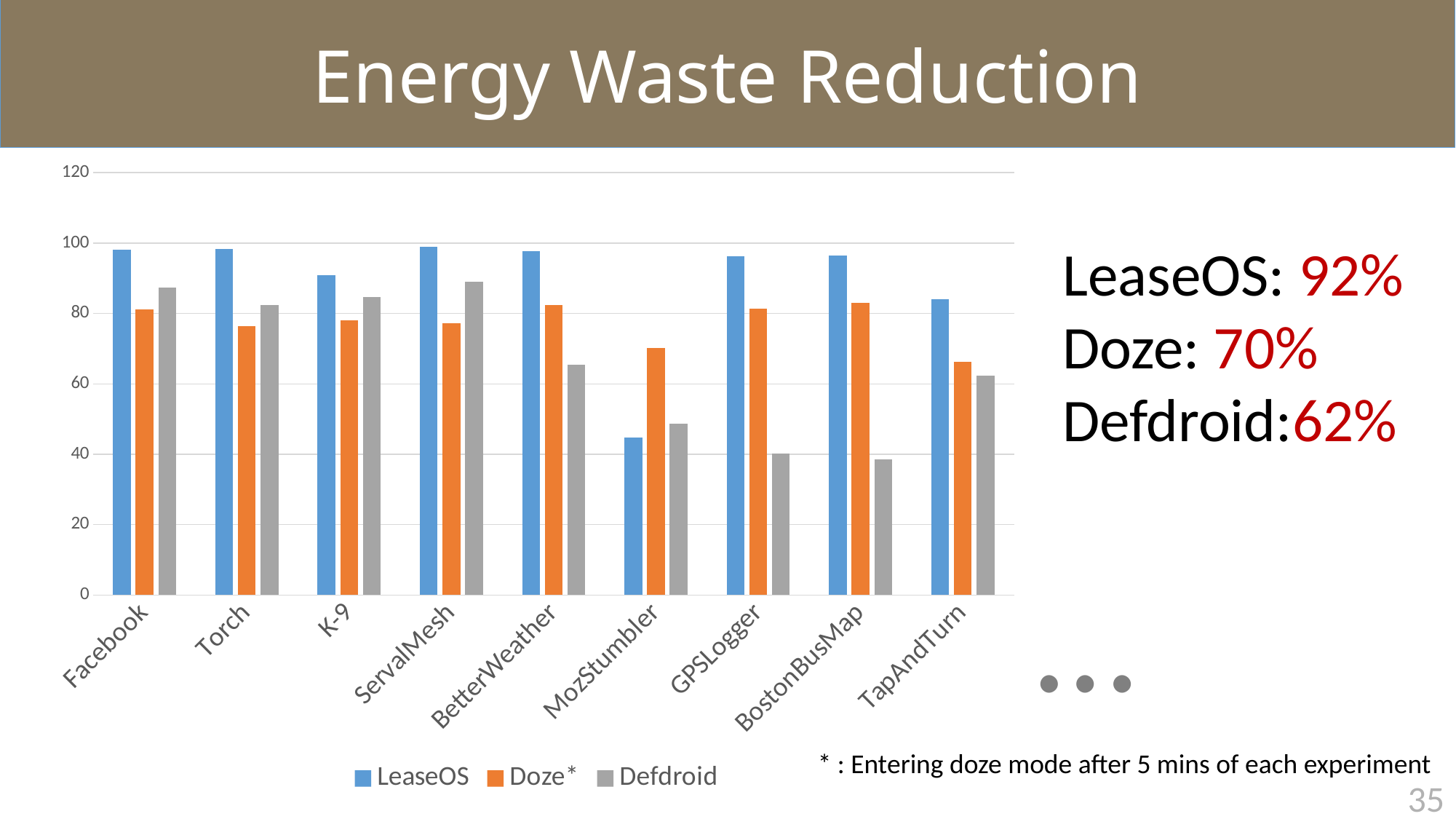
What is the title of the slide containing the chart? Energy Waste Reduction What kind of chart is shown on the slide? bar chart How many series does the legend list? 3 Which app has the lowest Doze* value? TapAndTurn Is the Defdroid value for GPSLogger greater or less than 60? less How many app categories are shown on the x axis? 9 For MozStumbler, which is larger: the LeaseOS value or the Doze* value? Doze* For Facebook, which is larger: the LeaseOS value or the Doze* value? LeaseOS Is the LeaseOS value for Facebook greater or less than 80? greater Which app has the lowest LeaseOS value? MozStumbler Is the LeaseOS value for MozStumbler greater or less than 60? less For GPSLogger, which is larger: the Doze* value or the Defdroid value? Doze*